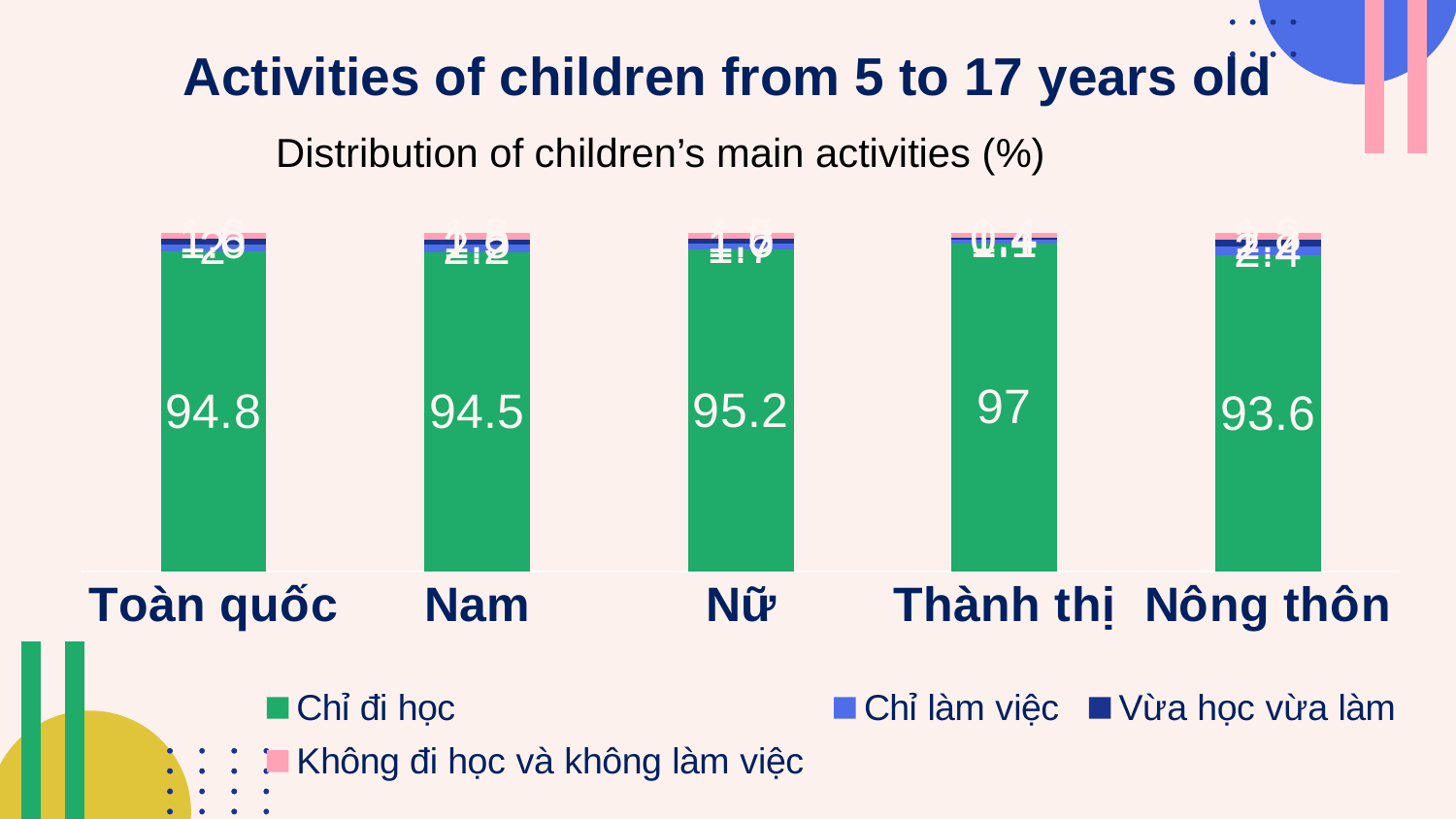
What is the value of "Chỉ đi học" for Nam? 94.5 What is the value of "Chỉ đi học" for Thành thị? 97 How many categories are shown on the x axis? 5 What is the difference between the "Chỉ đi học" values for Thành thị and Nông thôn? 3.4 Which has a larger "Chỉ đi học" value, Nam or Nữ? Nữ Which category has the lowest "Chỉ đi học" value? Nông thôn What is the value of "Chỉ đi học" for Toàn quốc? 94.8 How many series does the legend list? 4 Which category has the highest "Chỉ đi học" value? Thành thị What is the value of "Chỉ đi học" for Nữ? 95.2 What kind of chart is shown on the slide? Stacked bar chart What is the value of "Chỉ đi học" for Nông thôn? 93.6